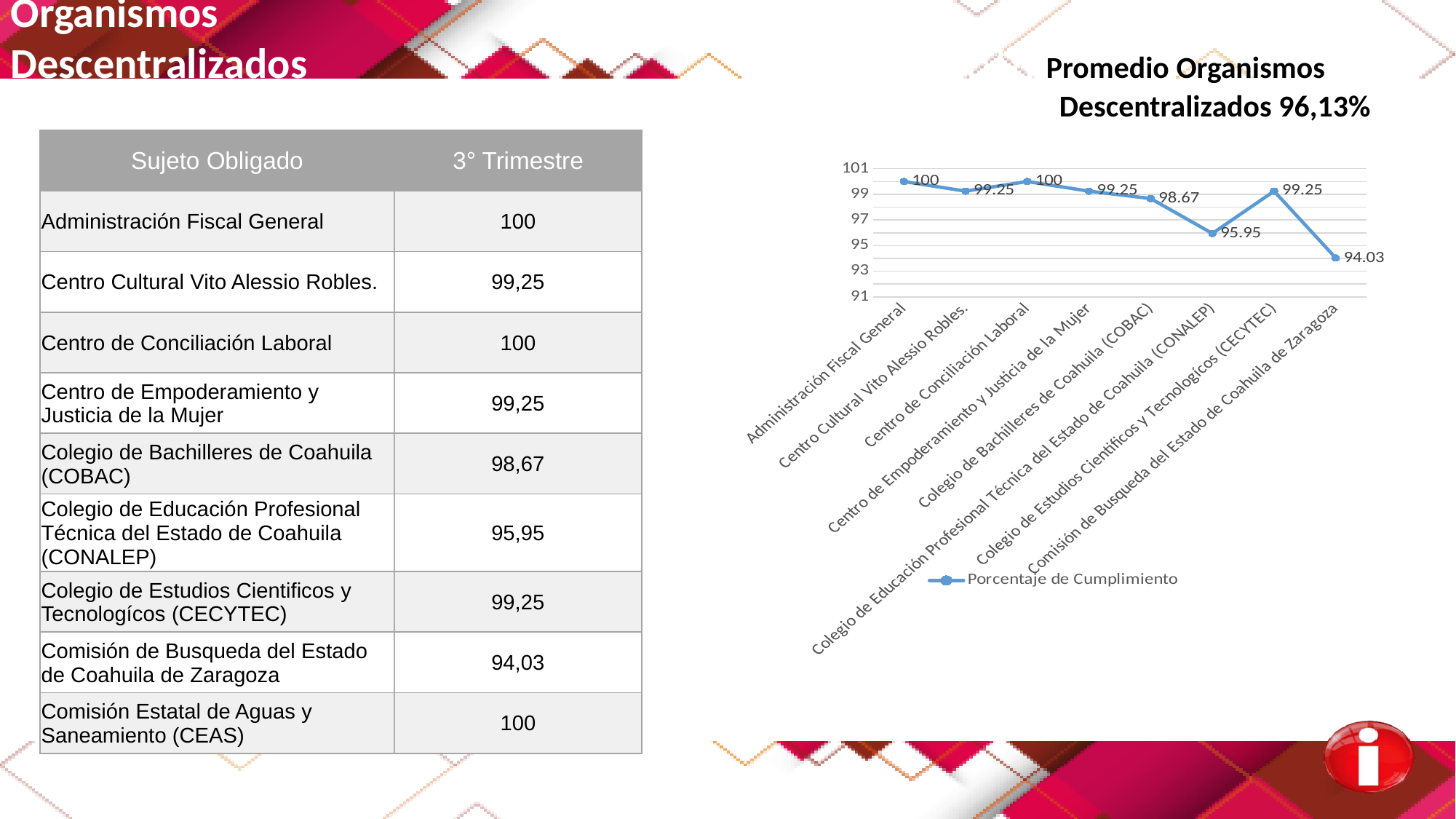
What is the value plotted for Colegio de Educación Profesional Técnica del Estado de Coahuila (CONALEP)? 95.95 Which category has the lowest value in the chart? Comisión de Busqueda del Estado de Coahuila de Zaragoza What is the difference between the values for Centro de Conciliación Laboral and Comisión de Busqueda del Estado de Coahuila de Zaragoza? 5.97 How many categories are plotted on the x axis of the chart? 8 What is the name of the series shown in the chart legend? Porcentaje de Cumplimiento Which is larger, the value for Colegio de Estudios Cientificos y Tecnologícos (CECYTEC) or the value for CONALEP? Colegio de Estudios Cientificos y Tecnologícos (CECYTEC) How many series does the chart legend list? 1 What is the value plotted for Comisión de Busqueda del Estado de Coahuila de Zaragoza? 94.03 What is the value plotted for Colegio de Bachilleres de Coahuila (COBAC)? 98.67 Is the value for CONALEP greater or less than 97? less What is the value plotted for Administración Fiscal General? 100 What kind of chart is shown on the slide? line chart